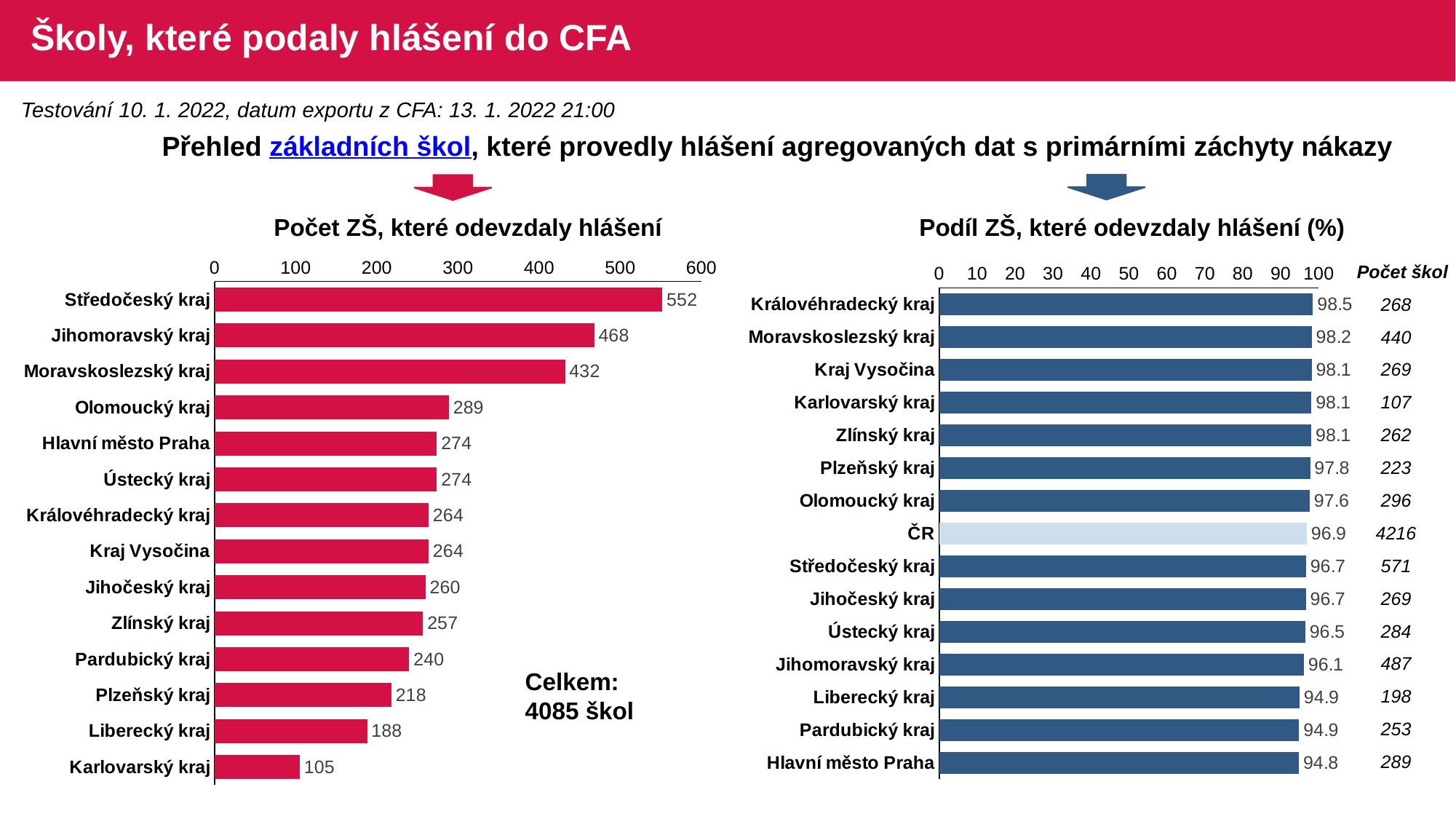
In the chart 'Podíl ZŠ, které odevzdaly hlášení (%)', what is the value for ČR? 96.9 In the chart 'Podíl ZŠ, které odevzdaly hlášení (%)', which category has the lowest value? Hlavní město Praha In the chart 'Počet ZŠ, které odevzdaly hlášení', how many regions are shown? 14 In the chart 'Počet ZŠ, které odevzdaly hlášení', which region has the lowest value? Karlovarský kraj What kind of chart is 'Počet ZŠ, které odevzdaly hlášení'? Bar chart In the chart 'Počet ZŠ, které odevzdaly hlášení', what is the value for Jihomoravský kraj? 468 In the chart 'Počet ZŠ, které odevzdaly hlášení', what is the value for Plzeňský kraj? 218 In the chart 'Podíl ZŠ, které odevzdaly hlášení (%)', how many bars are shown? 15 In the chart 'Počet ZŠ, které odevzdaly hlášení', which region has the highest value? Středočeský kraj In the chart 'Počet ZŠ, které odevzdaly hlášení', what is the difference between Středočeský kraj and Moravskoslezský kraj? 120 In the chart 'Podíl ZŠ, které odevzdaly hlášení (%)', which is larger: Plzeňský kraj or Liberecký kraj? Plzeňský kraj In the chart 'Podíl ZŠ, které odevzdaly hlášení (%)', what is the value for Královéhradecký kraj? 98.5